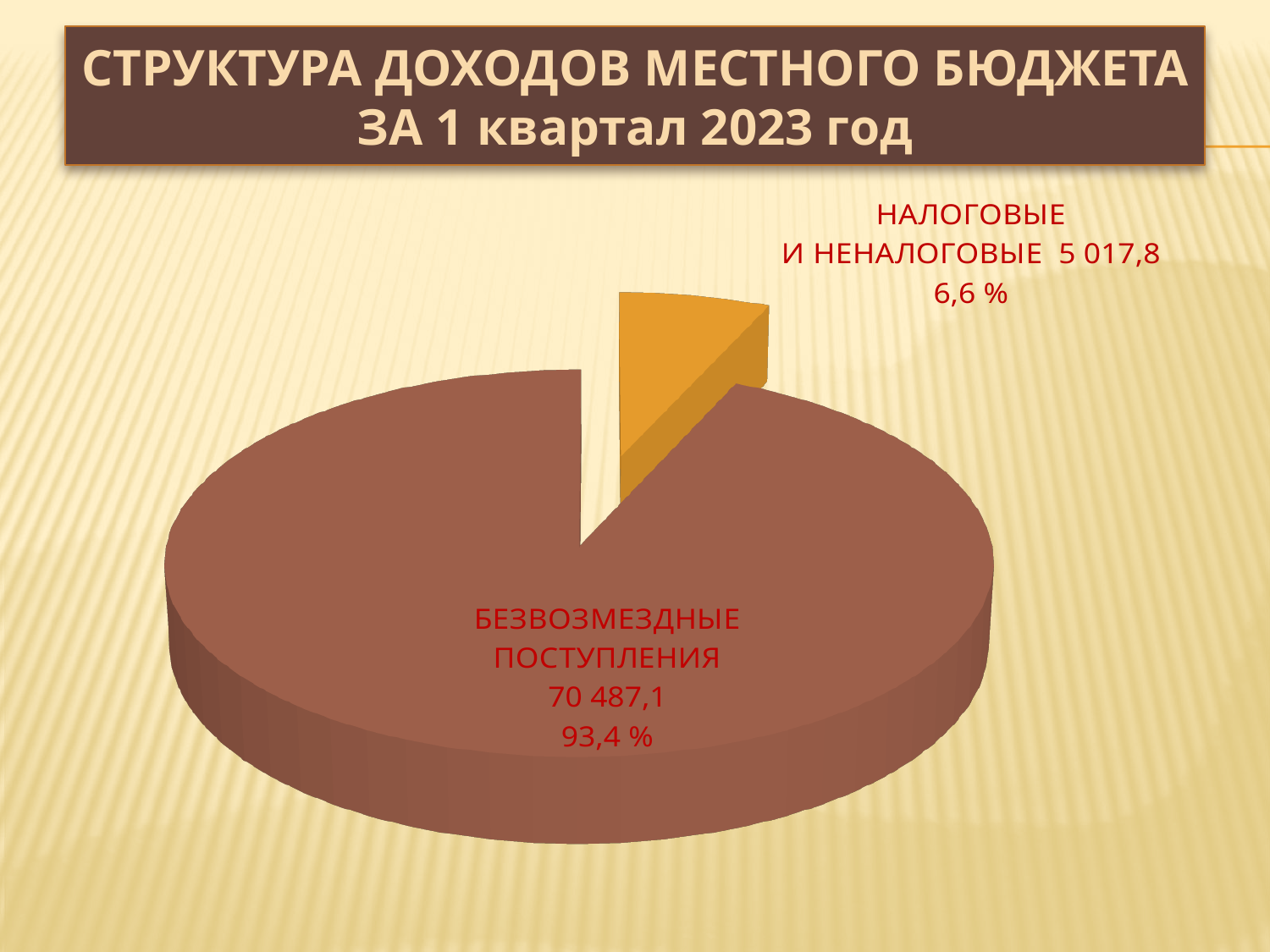
What is the total of the two values shown in the pie chart? 75 504,9 What is the value shown for БЕЗВОЗМЕЗДНЫЕ ПОСТУПЛЕНИЯ? 70 487,1 Which slice of the pie is the smallest? НАЛОГОВЫЕ И НЕНАЛОГОВЫЕ What is the value shown for НАЛОГОВЫЕ И НЕНАЛОГОВЫЕ? 5 017,8 Which is larger: БЕЗВОЗМЕЗДНЫЕ ПОСТУПЛЕНИЯ or НАЛОГОВЫЕ И НЕНАЛОГОВЫЕ? БЕЗВОЗМЕЗДНЫЕ ПОСТУПЛЕНИЯ What is the difference between the values for БЕЗВОЗМЕЗДНЫЕ ПОСТУПЛЕНИЯ and НАЛОГОВЫЕ И НЕНАЛОГОВЫЕ? 65 469,3 What kind of chart is shown on the slide? Pie chart What share of the pie does БЕЗВОЗМЕЗДНЫЕ ПОСТУПЛЕНИЯ represent? 93,4 % What share of the pie does НАЛОГОВЫЕ И НЕНАЛОГОВЫЕ represent? 6,6 % What is the title of the slide containing the pie chart? СТРУКТУРА ДОХОДОВ МЕСТНОГО БЮДЖЕТА ЗА 1 квартал 2023 год Which slice of the pie is the largest? БЕЗВОЗМЕЗДНЫЕ ПОСТУПЛЕНИЯ How many slices does the pie chart have? 2